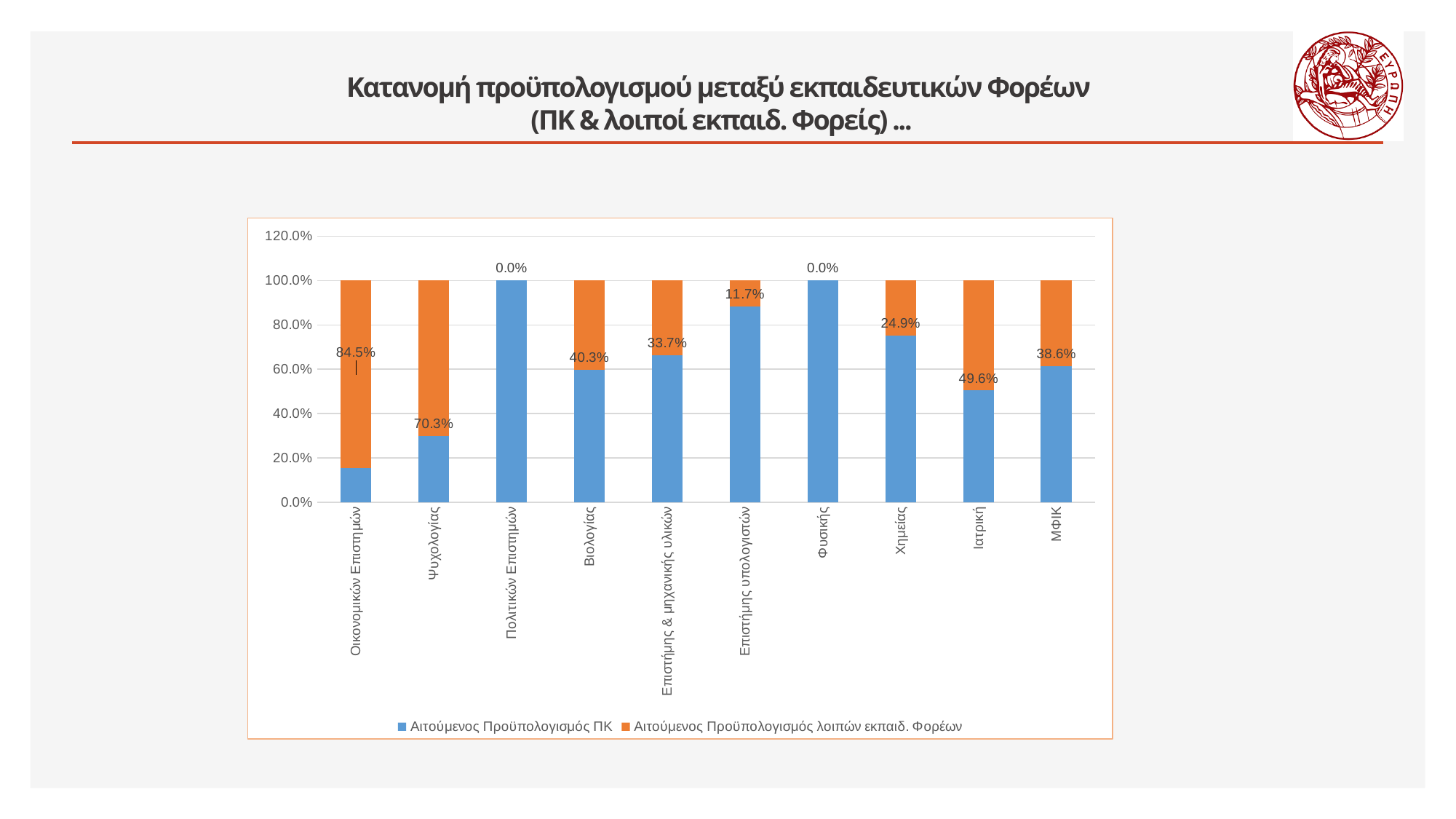
What is the difference between the Αιτούμενος Προϋπολογισμός λοιπών εκπαιδ. Φορέων values for Βιολογίας and Χημείας? 15.4% Which series is shown in orange in the chart? Αιτούμενος Προϋπολογισμός λοιπών εκπαιδ. Φορέων How many series does the legend list? 2 Which is larger, the Αιτούμενος Προϋπολογισμός λοιπών εκπαιδ. Φορέων value for ΜΦΙΚ or for Επιστήμης & μηχανικής υλικών? ΜΦΙΚ Is the value of Αιτούμενος Προϋπολογισμός ΠΚ for Φυσικής greater or less than 80.0%? greater What is the value of Αιτούμενος Προϋπολογισμός λοιπών εκπαιδ. Φορέων for Επιστήμης υπολογιστών? 11.7% What kind of chart is shown on the slide? stacked bar chart What is the value of Αιτούμενος Προϋπολογισμός λοιπών εκπαιδ. Φορέων for Ψυχολογίας? 70.3% Which category has the highest value for Αιτούμενος Προϋπολογισμός λοιπών εκπαιδ. Φορέων? Οικονομικών Επιστημών How many categories are shown on the x axis of the chart? 10 What is the value of Αιτούμενος Προϋπολογισμός λοιπών εκπαιδ. Φορέων for Ιατρική? 49.6% What is the value of Αιτούμενος Προϋπολογισμός λοιπών εκπαιδ. Φορέων for Οικονομικών Επιστημών? 84.5%